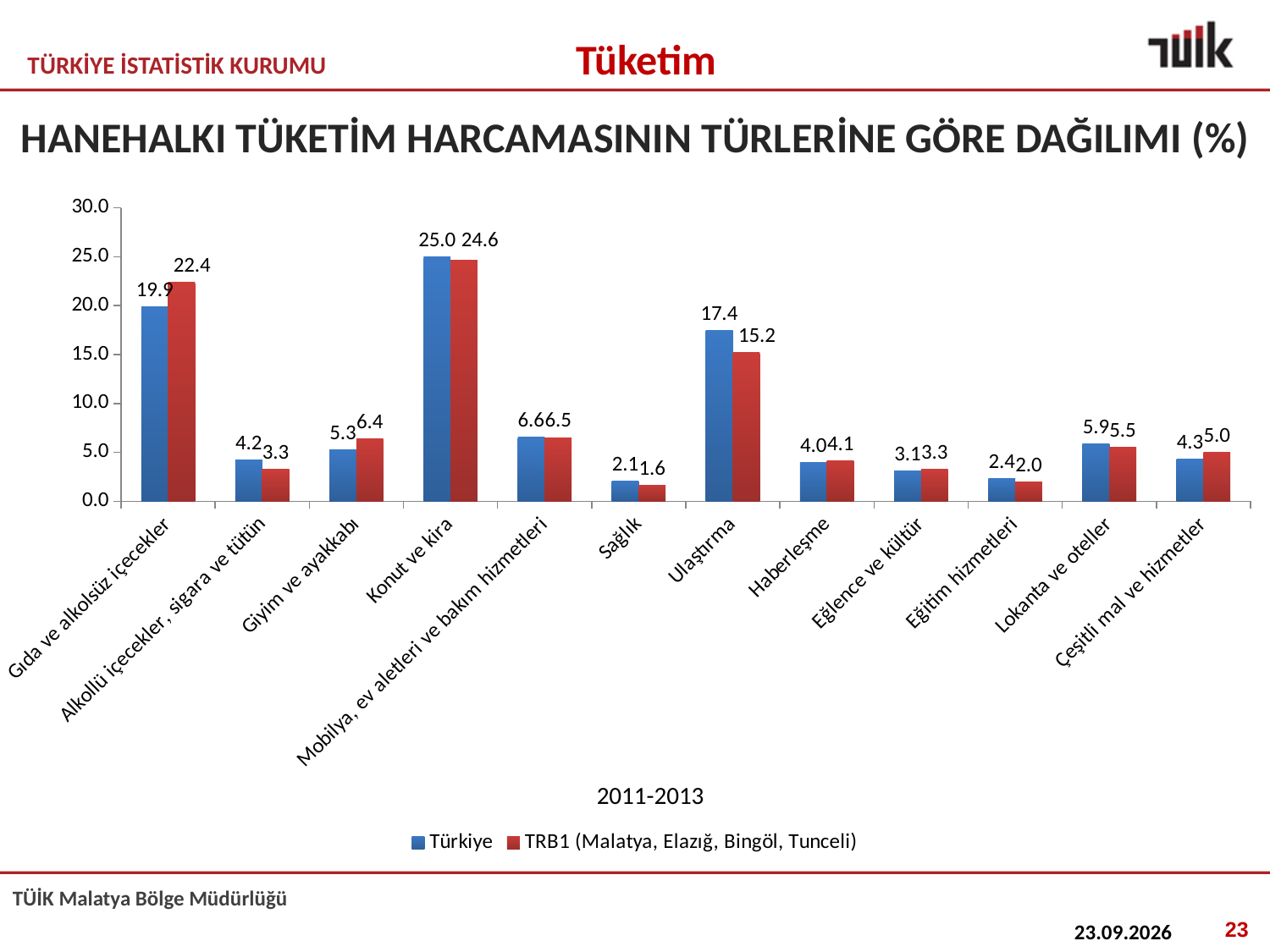
How many series does the legend list? 2 Is the Türkiye value for Konut ve kira greater or less than 20.0? greater For Gıda ve alkolsüz içecekler, which series has the larger value, Türkiye or TRB1? TRB1 (Malatya, Elazığ, Bingöl, Tunceli) What is the Türkiye value for Ulaştırma? 17.4 What is the difference between the Türkiye and TRB1 values for Ulaştırma? 2.2 Which category has the lowest Türkiye value? Sağlık How many categories are shown on the x axis? 12 What is the TRB1 (Malatya, Elazığ, Bingöl, Tunceli) value for Gıda ve alkolsüz içecekler? 22.4 Which category has the highest TRB1 (Malatya, Elazığ, Bingöl, Tunceli) value? Konut ve kira What is the Türkiye value for Konut ve kira? 25.0 What kind of chart is shown on the slide? Bar chart What period is shown below the x axis of the chart? 2011-2013